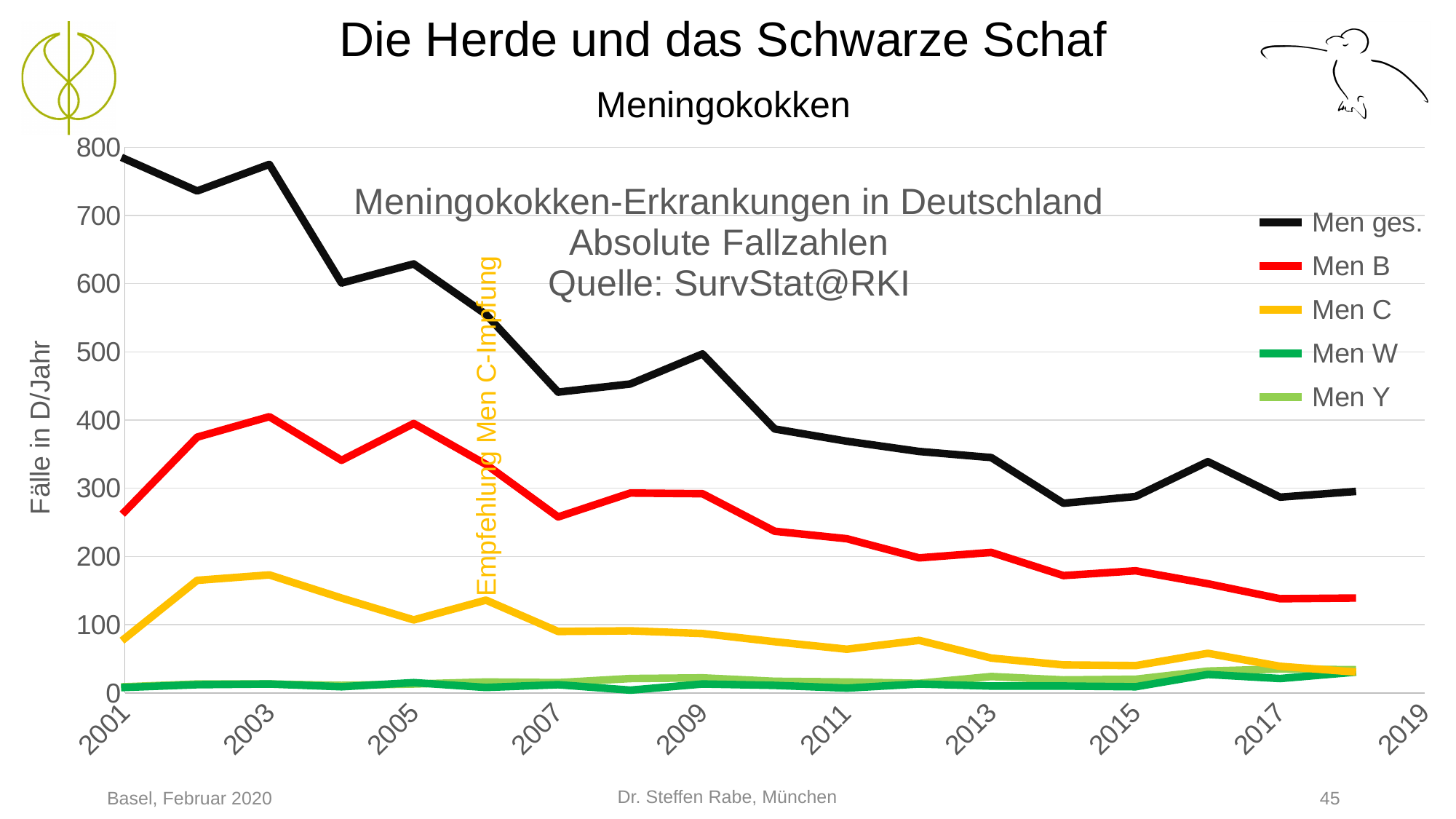
Does the Men C series rise or fall overall from 2003 to 2018? fall How many series does the legend list? 5 What kind of chart is shown on the slide? line chart What does the vertical orange annotation on the chart say? Empfehlung Men C-Impfung Does the Men ges. series rise or fall overall from 2001 to 2018? fall What is the label on the vertical axis? Fälle in D/Jahr Is the value for Men ges. in 2014 greater or less than 300? less In 2007, which is larger: Men B or Men C? Men B Is the value for Men C in 2003 greater or less than 100? greater Is the value for Men B in 2018 greater or less than 200? less Which series has the highest values across the whole chart? Men ges.